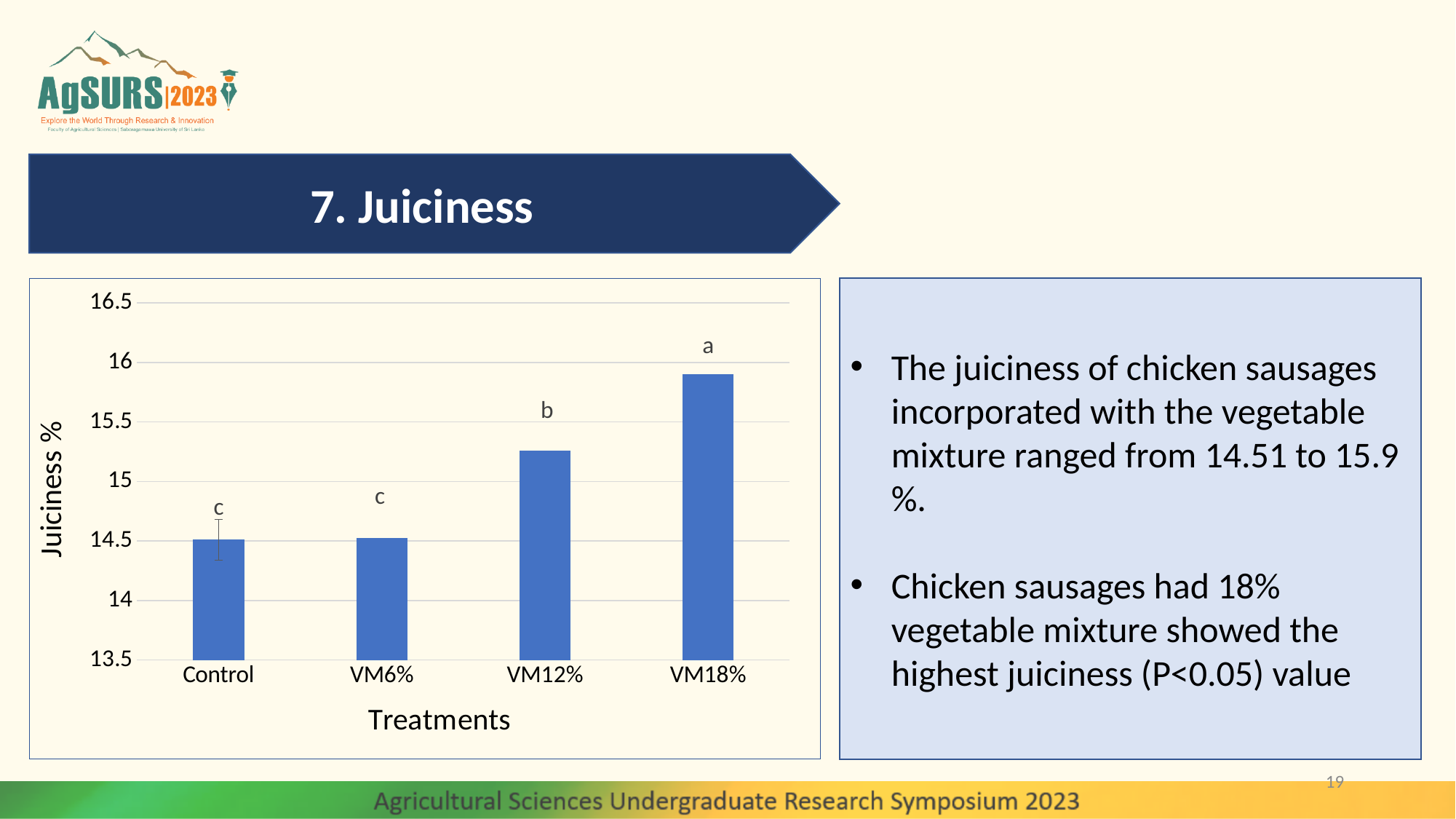
Is the juiciness value for VM18% greater or less than 15.5? greater Is the juiciness value for VM6% greater or less than 15? less What kind of chart is shown on the slide? bar chart Which has the larger juiciness value, VM6% or VM12%? VM12% How many treatments are plotted on the x axis of the chart? 4 Is the juiciness value for VM12% greater or less than 15? greater What is the label of the y axis of the chart? Juiciness % Which has the larger juiciness value, VM12% or VM18%? VM18% Do the juiciness values rise or fall from Control to VM18% along the x axis? rise Which treatment has the highest juiciness value in the chart? VM18% What letter is printed above the VM18% bar? a